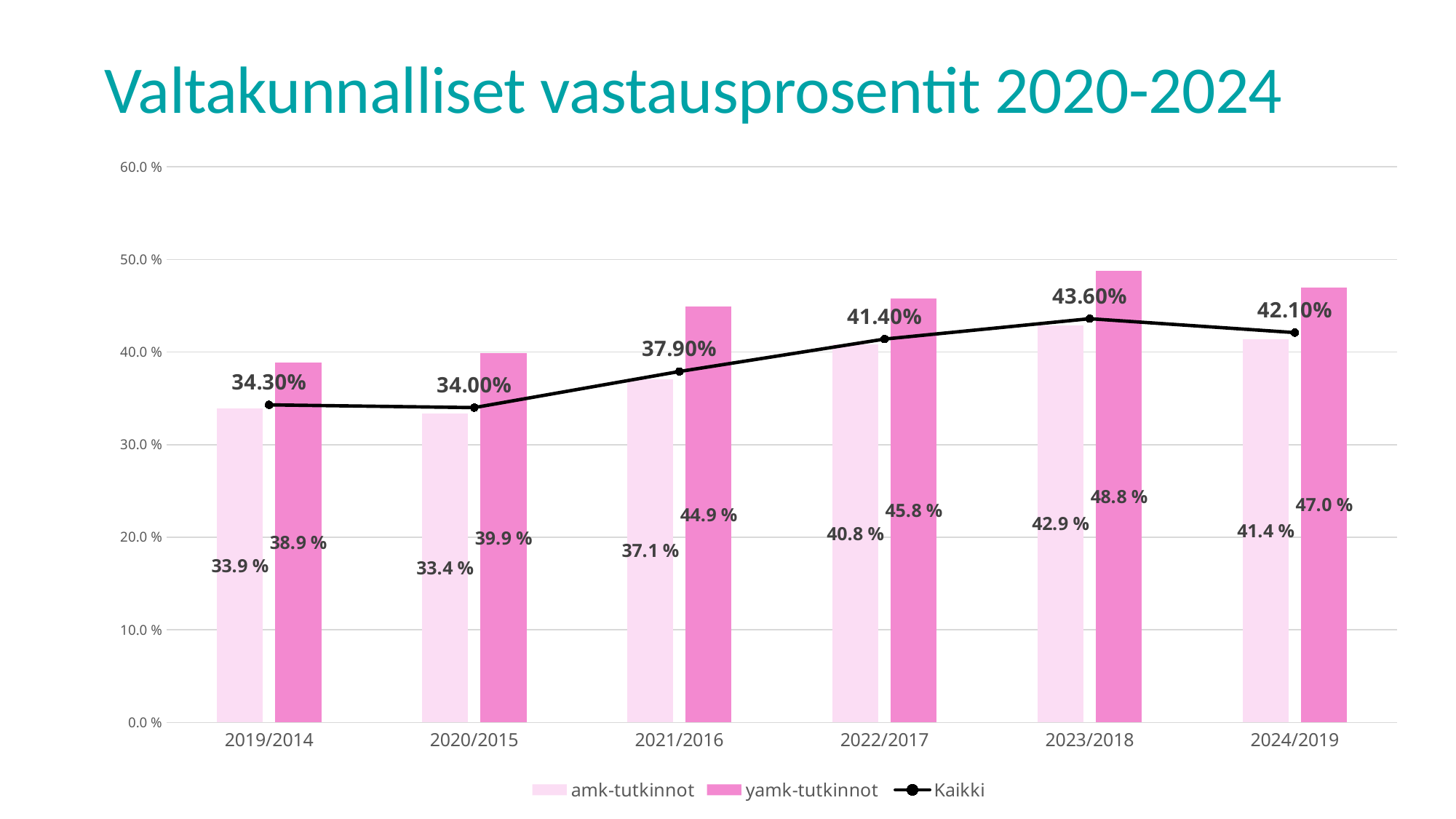
What is the value for amk-tutkinnot in 2020/2015? 33.4 % Which is larger in 2022/2017: the amk-tutkinnot value or the yamk-tutkinnot value? yamk-tutkinnot In which category is the yamk-tutkinnot value highest? 2023/2018 What is the difference between the yamk-tutkinnot and amk-tutkinnot values in 2024/2019? 5.6 % What is the value for yamk-tutkinnot in 2023/2018? 48.8 % What is the Kaikki value for 2024/2019? 42.10% In which category is the amk-tutkinnot value lowest? 2020/2015 Does the Kaikki line rise or fall from 2019/2014 to 2023/2018? rise How many series does the legend list? 3 What is the value for amk-tutkinnot in 2021/2016? 37.1 % What is the title of the chart? Valtakunnalliset vastausprosentit 2020-2024 How many categories are shown on the x axis? 6